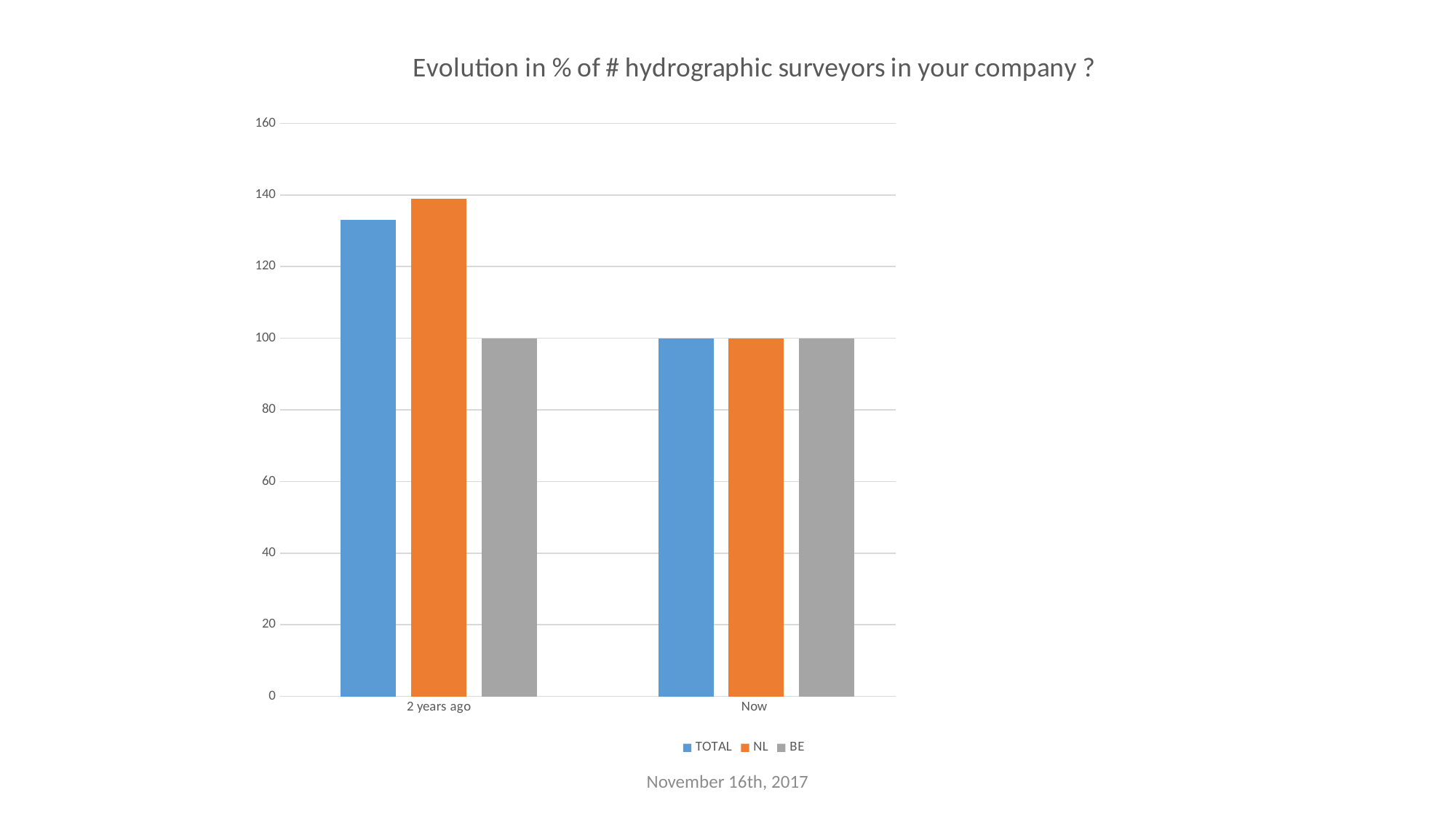
What is the value for NL in the 'Now' category? 100 In the '2 years ago' category, which is larger, TOTAL or NL? NL How many categories are shown on the x axis? 2 Which series has the lowest value in the '2 years ago' category? BE Does the TOTAL series rise or fall from '2 years ago' to 'Now'? fall Is the value for TOTAL in the '2 years ago' category greater or less than 120? greater Which series has the highest value in the '2 years ago' category? NL How many series does the legend list? 3 What is the value for TOTAL in the 'Now' category? 100 What kind of chart is shown on the slide? bar chart What is the value for BE in the '2 years ago' category? 100 What is the title of the chart? Evolution in % of # hydrographic surveyors in your company ?